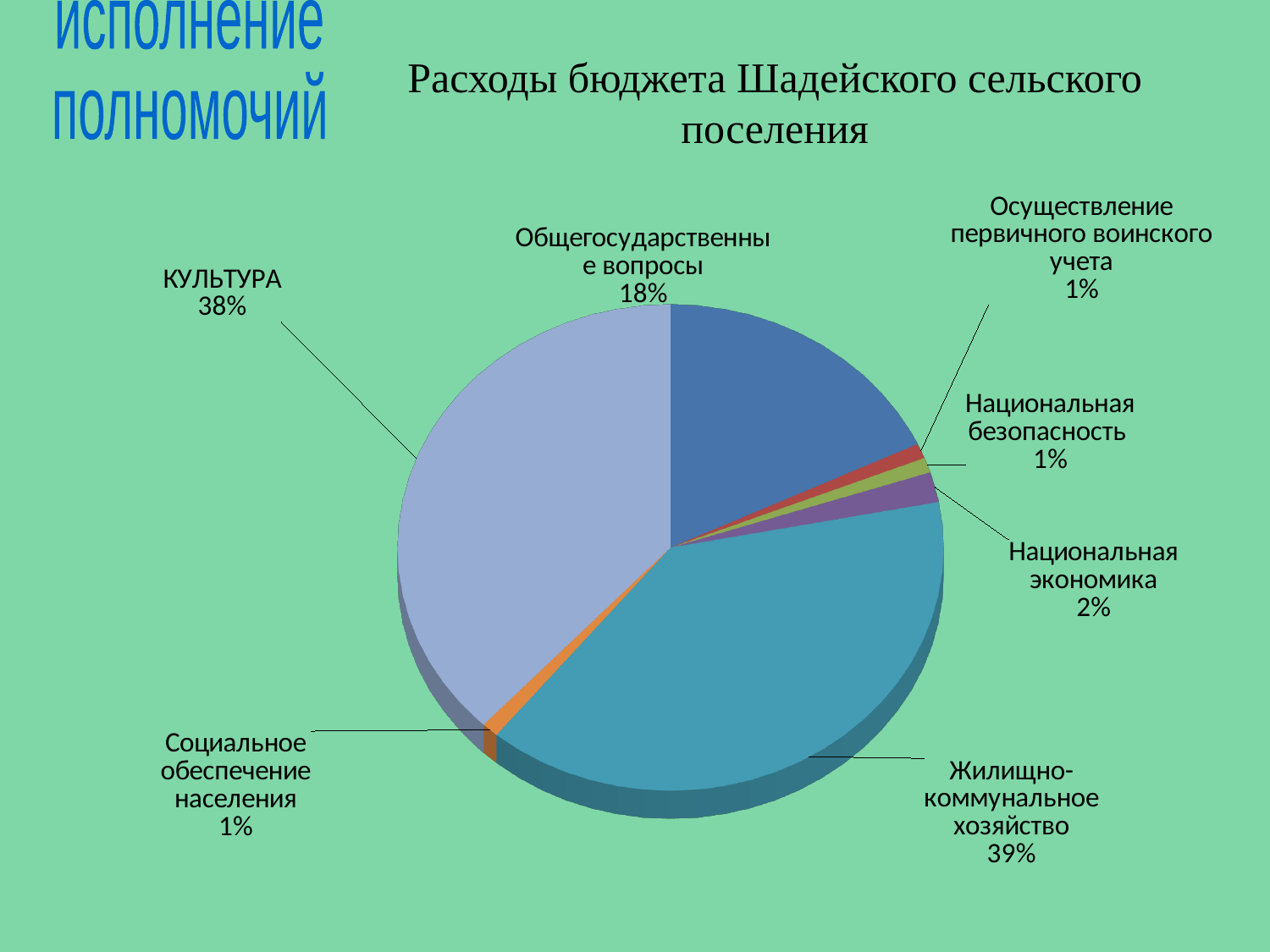
What percentage is labelled for Социальное обеспечение населения? 1% What is the combined share of КУЛЬТУРА and Жилищно-коммунальное хозяйство? 77% Which category has the largest share of the budget expenses? Жилищно-коммунальное хозяйство What is the difference in percentage points between Жилищно-коммунальное хозяйство and Общегосударственные вопросы? 21% What share does Национальная экономика have in the pie chart? 2% How many categories (slices) does the pie chart have? 7 What is the title of the chart? Расходы бюджета Шадейского сельского поселения What type of chart is shown on the slide? pie chart What percentage is shown for Общегосударственные вопросы? 18% Which is larger: the share for КУЛЬТУРА or the share for Общегосударственные вопросы? КУЛЬТУРА What share of the budget expenses goes to КУЛЬТУРА? 38% What percentage is shown for Жилищно-коммунальное хозяйство? 39%